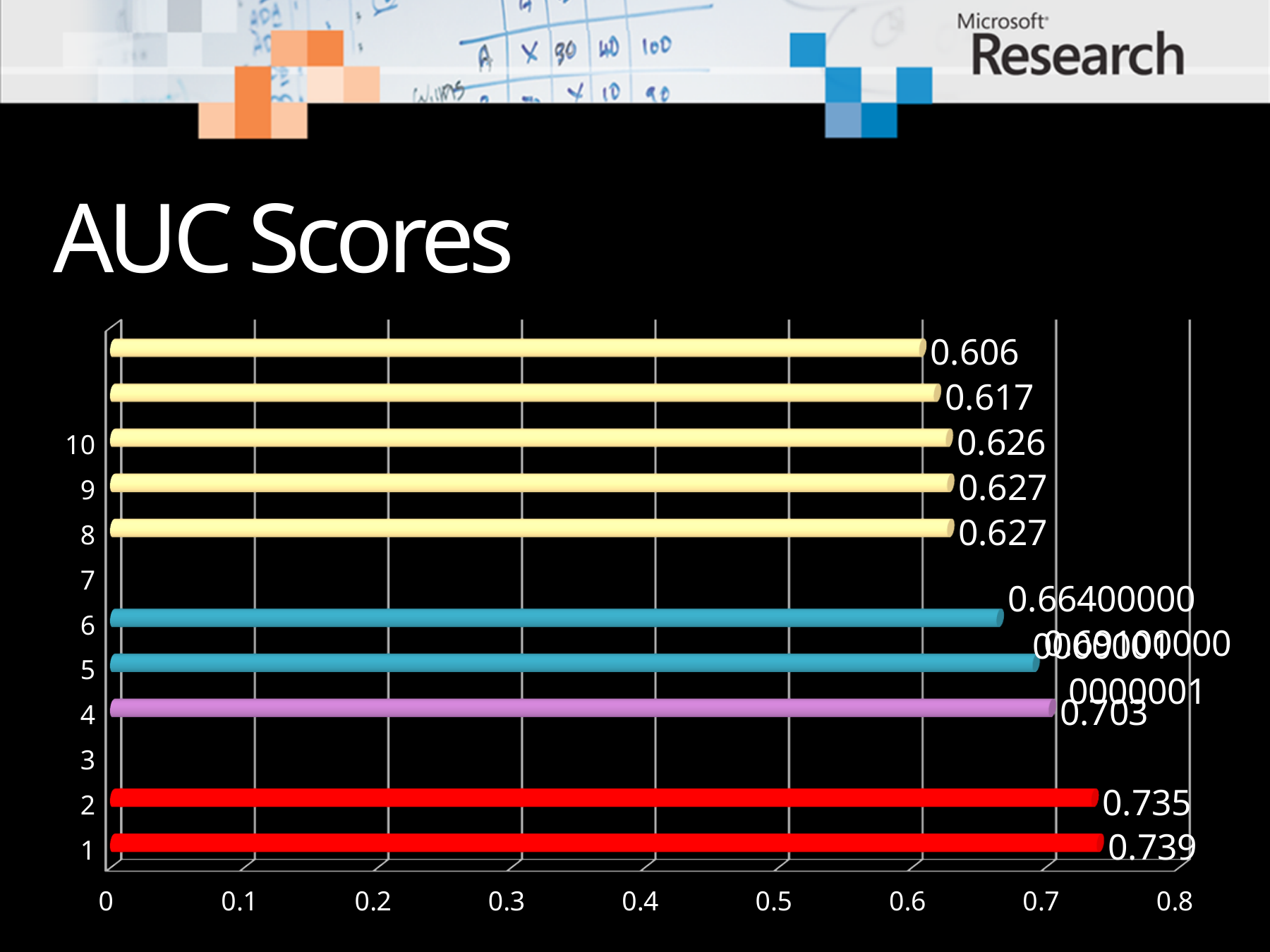
Which has a higher AUC score, category 4 or category 6? Category 4 What is the AUC score for category 2? 0.735 What is the AUC score for category 8? 0.627 What is the title of the chart? AUC Scores What type of chart is shown on the slide? Bar chart Which labelled category has the highest AUC score? 1 What is the AUC score for category 10? 0.626 What is the AUC score for category 4? 0.703 Is the AUC score for category 6 greater or less than 0.7? less What is the lowest AUC score shown on the chart? 0.606 What is the AUC score for category 1? 0.739 What is the difference between the AUC scores of category 1 and category 2? 0.004